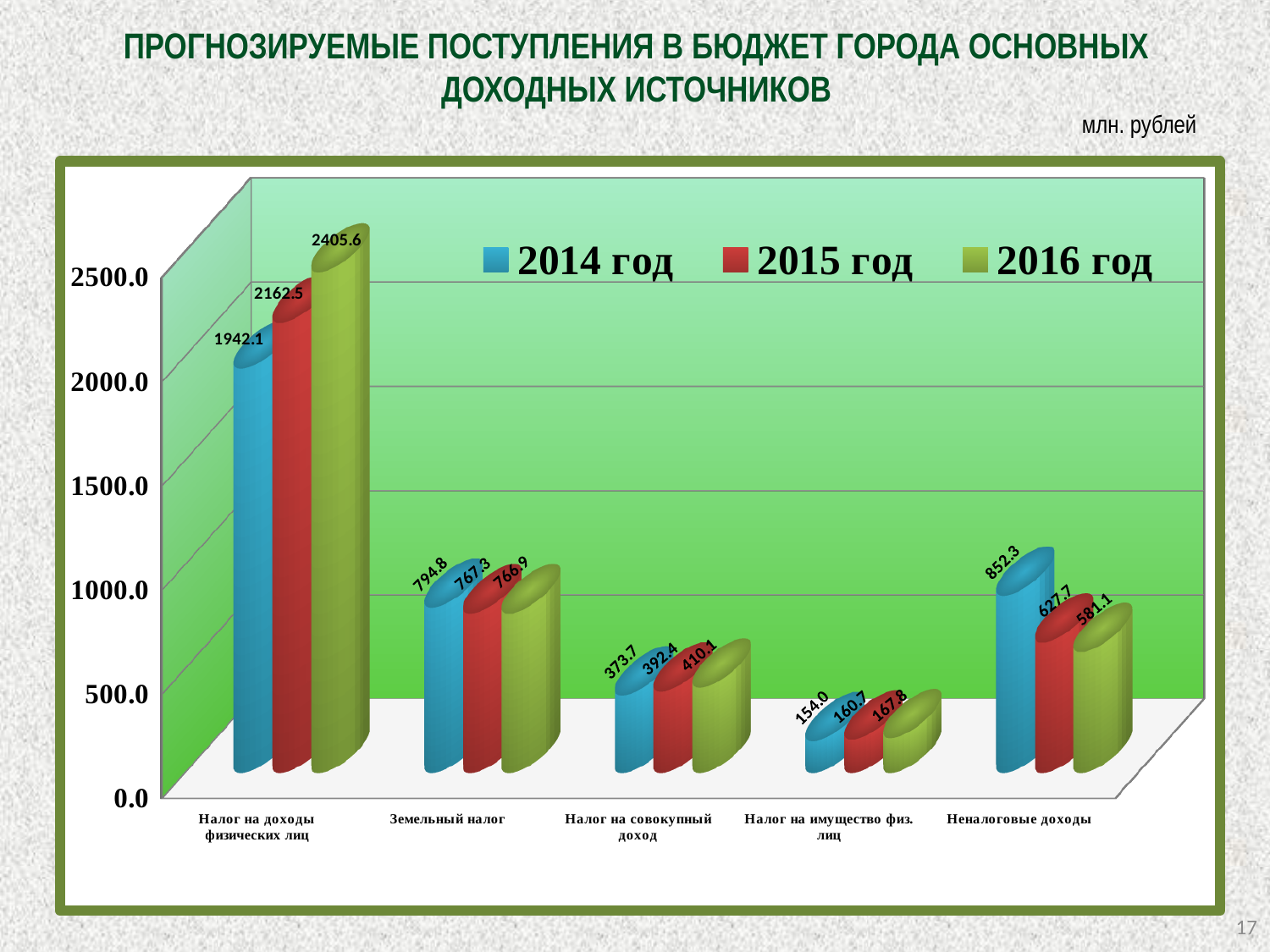
What kind of chart is shown on the slide? bar chart Which is larger for Неналоговые доходы: the 2014 год value or the 2015 год value? 2014 год Is the value for Земельный налог in 2014 год greater or less than 1000.0? less Which category has the lowest value in 2014 год? Налог на имущество физ. лиц Do the values for Налог на совокупный доход rise or fall from 2014 год to 2016 год? rise What is the value for Налог на имущество физ. лиц in 2015 год? 160.7 What is the value for Неналоговые доходы in 2016 год? 581.1 What is the difference between the 2016 год and 2014 год values for Налог на доходы физических лиц? 463.5 What is the value for Налог на доходы физических лиц in 2014 год? 1942.1 Which category has the highest value in 2016 год? Налог на доходы физических лиц How many categories are shown on the x axis? 5 How many series does the legend list? 3